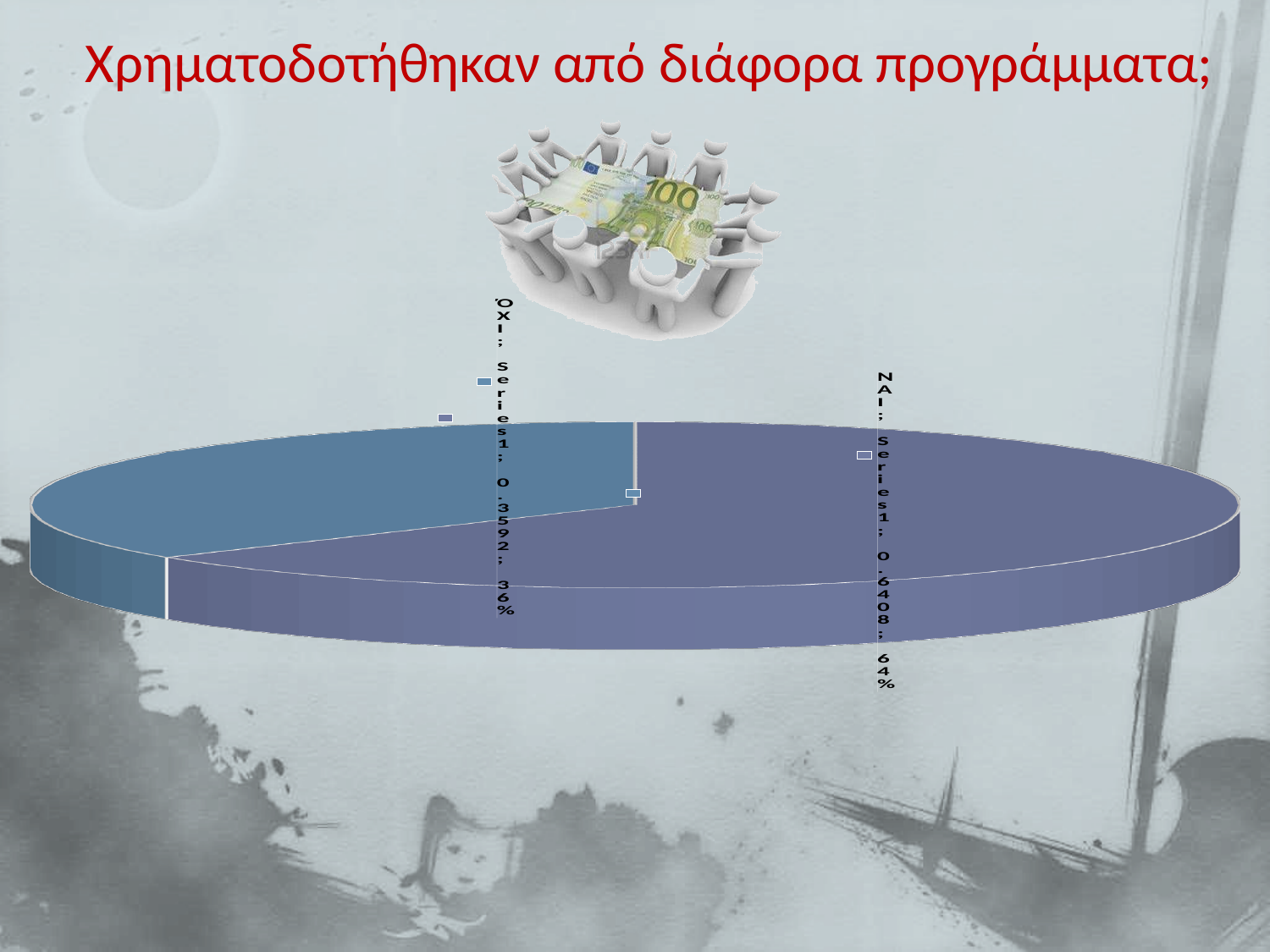
What series name is shown in the data labels of the pie chart? Series1 What value is printed for the ΌΧΙ slice? 0.3592 What percentage share does the ΝΑΙ slice have? 64% What kind of chart is shown on the slide? pie chart What value is printed for the ΝΑΙ slice? 0.6408 What is the difference in percentage points between the ΝΑΙ and ΌΧΙ slices? 28 What percentage share does the ΌΧΙ slice have? 36% What is the title of the chart on the slide? Χρηματοδοτήθηκαν από διάφορα προγράμματα; Which slice is the smallest in the pie chart? ΌΧΙ Which slice is larger, ΝΑΙ or ΌΧΙ? ΝΑΙ How many slices does the pie chart have? 2 Which slice is the largest in the pie chart? ΝΑΙ